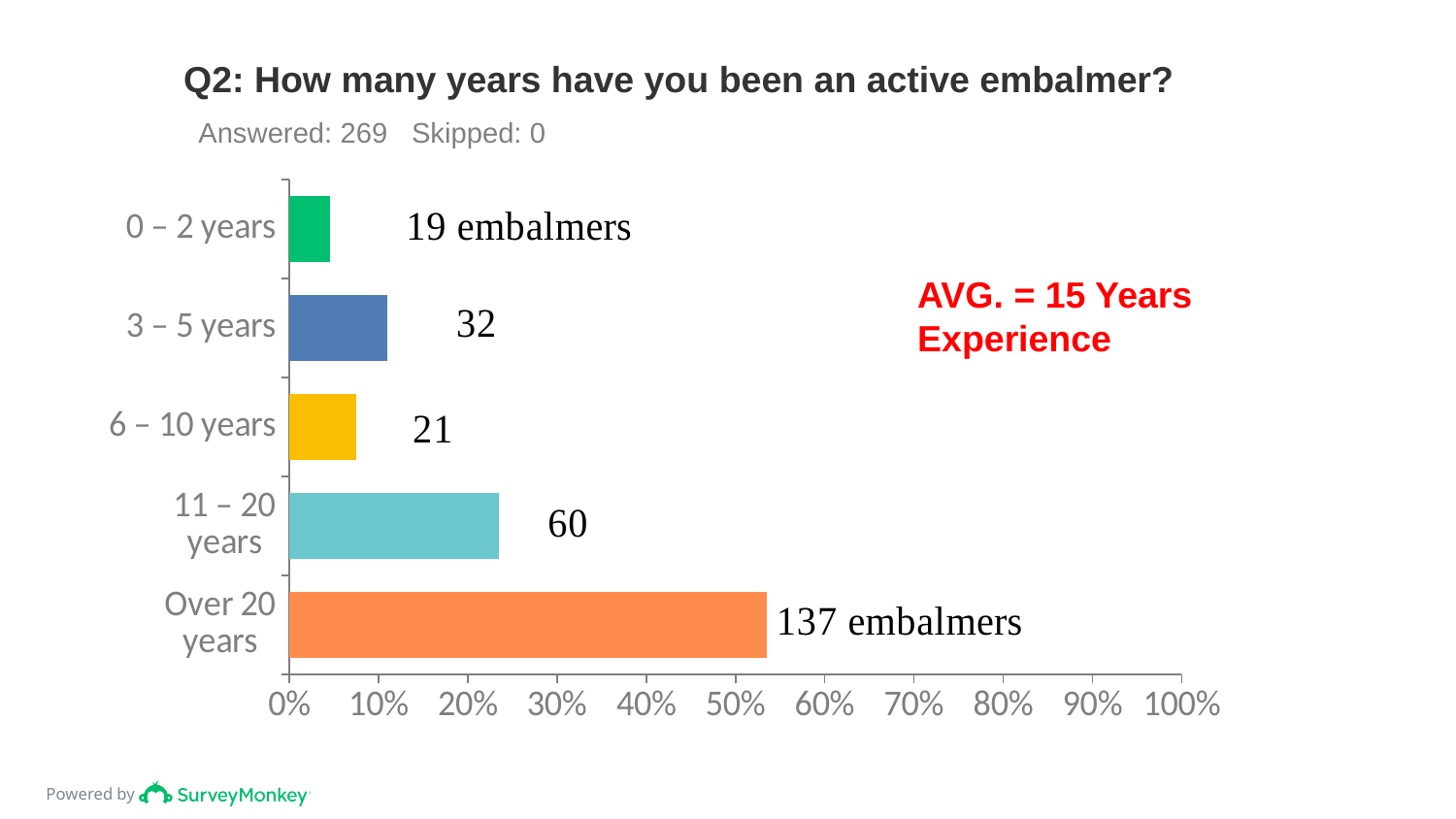
Which experience category has the highest number of embalmers? Over 20 years How many embalmers reported over 20 years of experience? 137 embalmers Which category has more embalmers, 3 – 5 years or 6 – 10 years? 3 – 5 years What is the difference between the number of embalmers with over 20 years and those with 11 – 20 years of experience? 77 What is the number shown for the 11 – 20 years category? 60 Is the percentage for the Over 20 years bar greater or less than 40%? greater What type of chart is shown on the slide? Bar chart What is the number shown for the 3 – 5 years category? 32 How many embalmers reported 0 – 2 years of experience? 19 embalmers Which experience category has the lowest number of embalmers? 0 – 2 years How many experience categories are shown in the chart? 5 Is the percentage for the 0 – 2 years bar greater or less than 10%? less